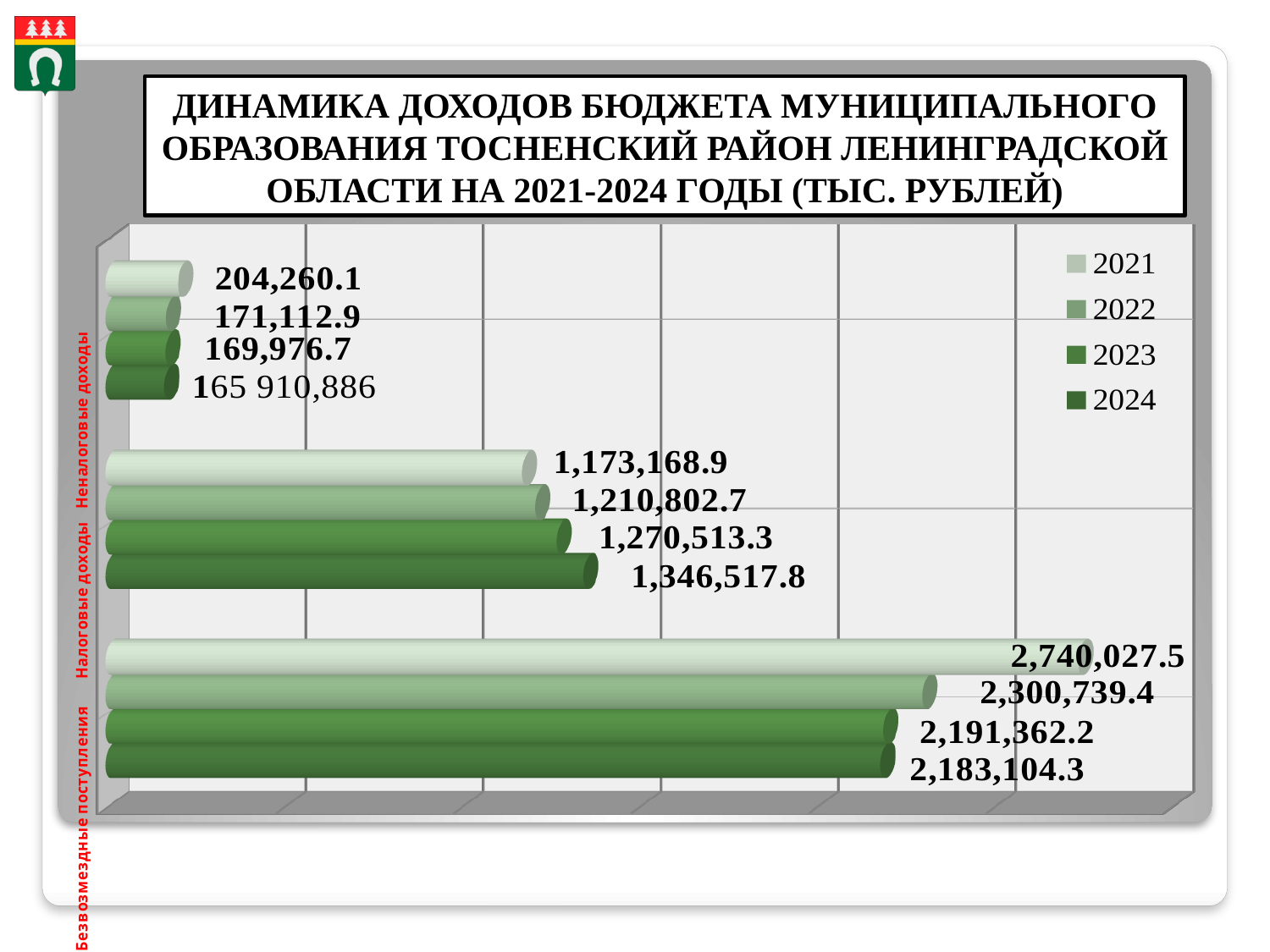
Which year has the lowest value for Налоговые доходы? 2021 What is the difference between the 2021 and 2024 values for Безвозмездные поступления? 556,923.2 Do the values for Налоговые доходы rise or fall from 2021 to 2024? Rise What is the value for Безвозмездные поступления in 2021? 2,740,027.5 What is the value for Неналоговые доходы in 2022? 171,112.9 What is the difference between the 2024 and 2021 values for Налоговые доходы? 173,348.9 What kind of chart is shown on the slide? Bar chart Which year has the highest value for Безвозмездные поступления? 2021 Which is larger: Безвозмездные поступления in 2022 or Безвозмездные поступления in 2023? Безвозмездные поступления in 2022 How many series does the legend list? 4 What is the value for Налоговые доходы in 2023? 1,270,513.3 What is the value for Налоговые доходы in 2024? 1,346,517.8